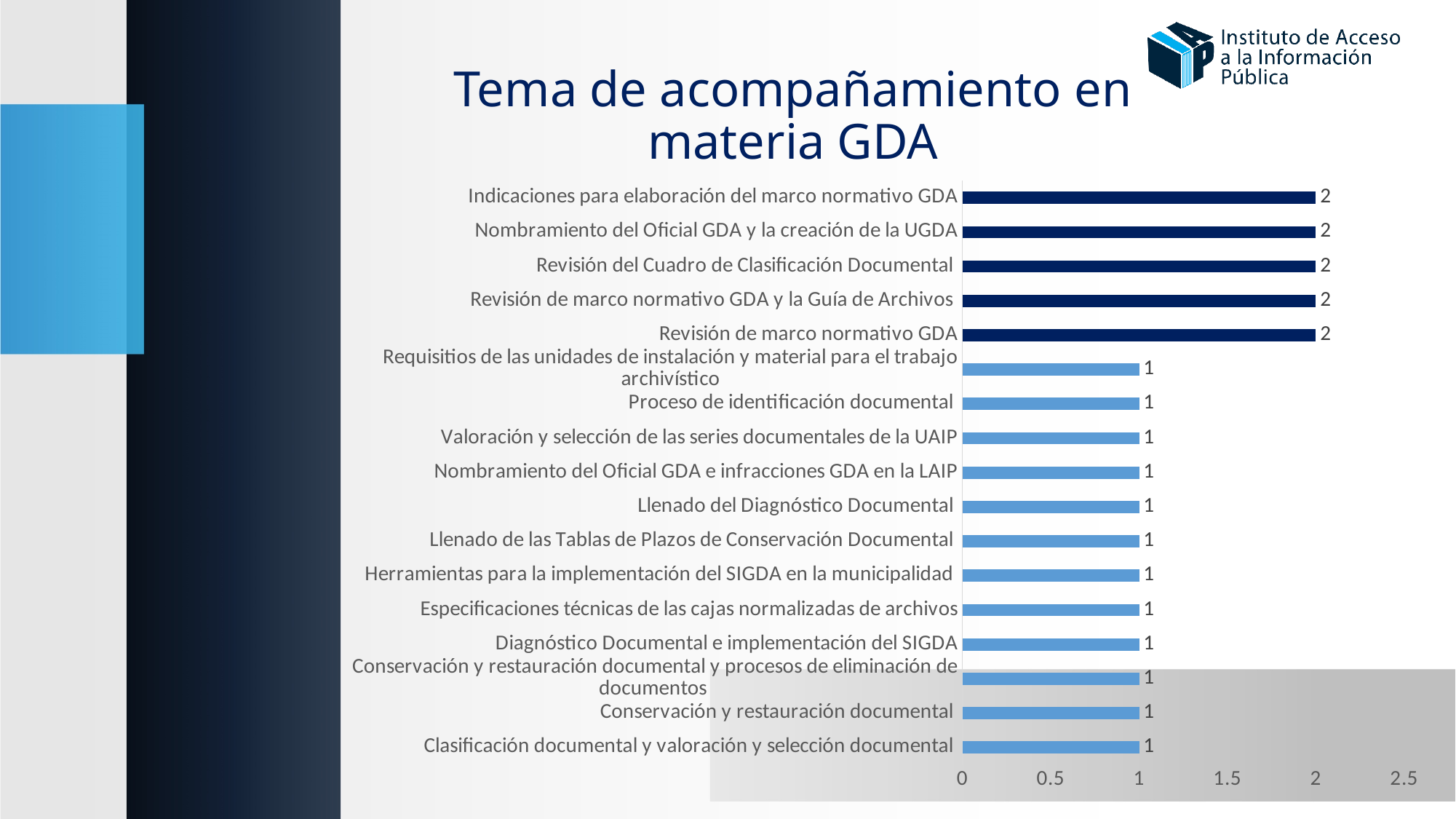
How many categories are shown in the chart? 17 What is the difference between the value for "Indicaciones para elaboración del marco normativo GDA" and the value for "Diagnóstico Documental e implementación del SIGDA"? 1 What is the highest value shown on the horizontal axis? 2.5 How many categories have a value of 2? 5 Which is larger, the value for "Revisión de marco normativo GDA" or the value for "Proceso de identificación documental"? Revisión de marco normativo GDA Is the value for "Revisión de marco normativo GDA y la Guía de Archivos" greater or less than 1.5? greater What is the value for "Conservación y restauración documental"? 1 What kind of chart is shown on the slide? Bar chart What is the value for "Revisión del Cuadro de Clasificación Documental"? 2 What is the title of the chart on the slide? Tema de acompañamiento en materia GDA What is the value for "Llenado del Diagnóstico Documental"? 1 What is the value for "Nombramiento del Oficial GDA y la creación de la UGDA"? 2